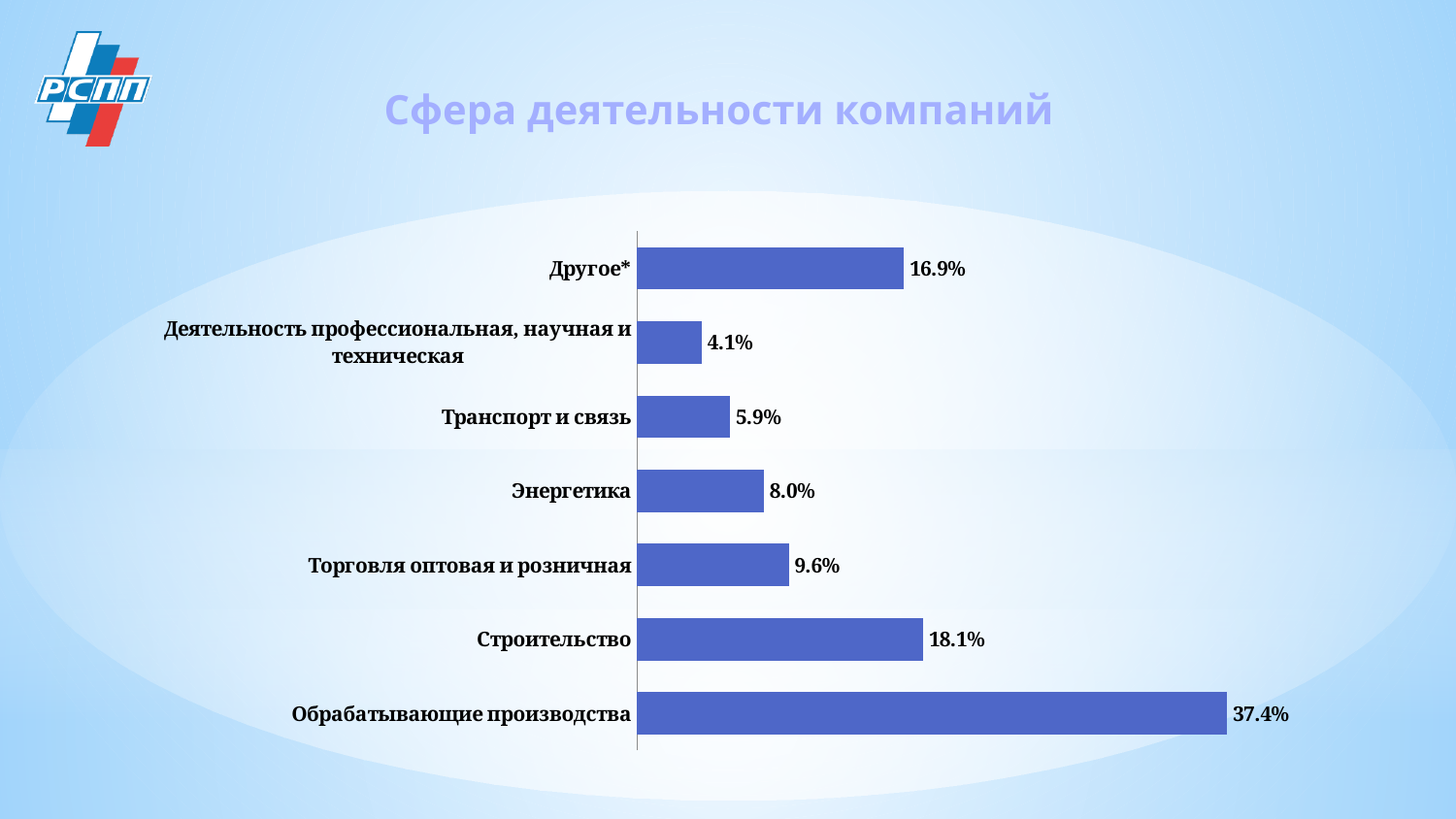
What is the value for Строительство? 18.1% Which category has the highest value? Обрабатывающие производства What is the difference between the values for Обрабатывающие производства and Строительство? 19.3% Which category has the lowest value? Деятельность профессиональная, научная и техническая How many categories are shown in the chart? 7 What is the title of the slide? Сфера деятельности компаний What is the difference between the values for Торговля оптовая и розничная and Транспорт и связь? 3.7% What is the value for Энергетика? 8.0% What is the value for Деятельность профессиональная, научная и техническая? 4.1% What is the value for Обрабатывающие производства? 37.4% What kind of chart is shown on the slide? Bar chart Which is larger, the value for Другое* or the value for Строительство? Строительство